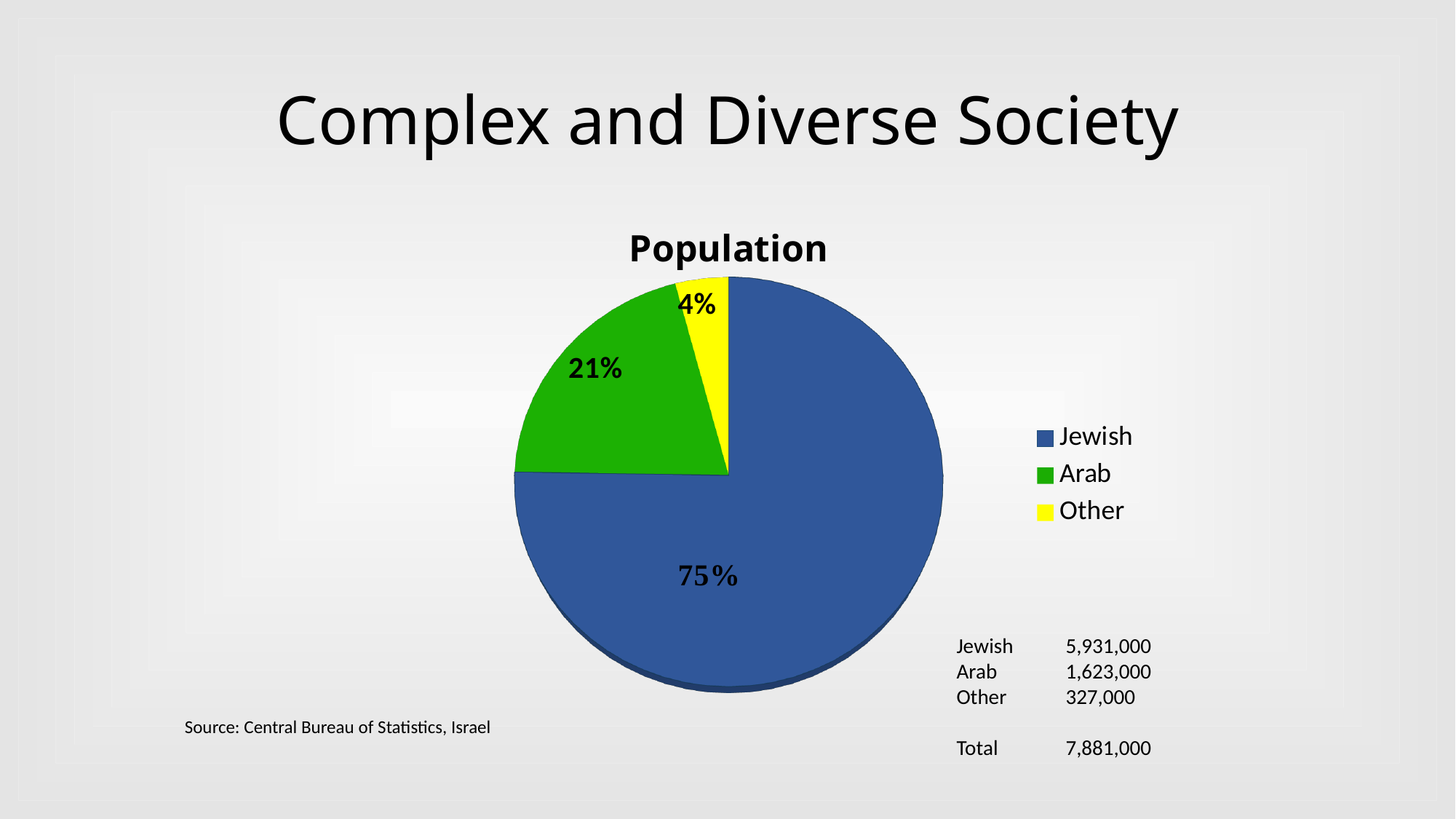
What share of the Population pie chart is Arab? 21% Which slice is larger, Arab or Other? Arab What share of the Population pie chart is Other? 4% What share of the Population pie chart is Jewish? 75% Which category has the smallest slice in the Population pie chart? Other What is the difference in percentage points between the Jewish and Arab slices? 54 percentage points What is the title of the chart? Population How many slices does the Population pie chart have? 3 How many entries does the legend list? 3 What kind of chart is shown on the slide? Pie chart What colour is the Arab slice in the pie chart? Green Which category has the largest slice in the Population pie chart? Jewish